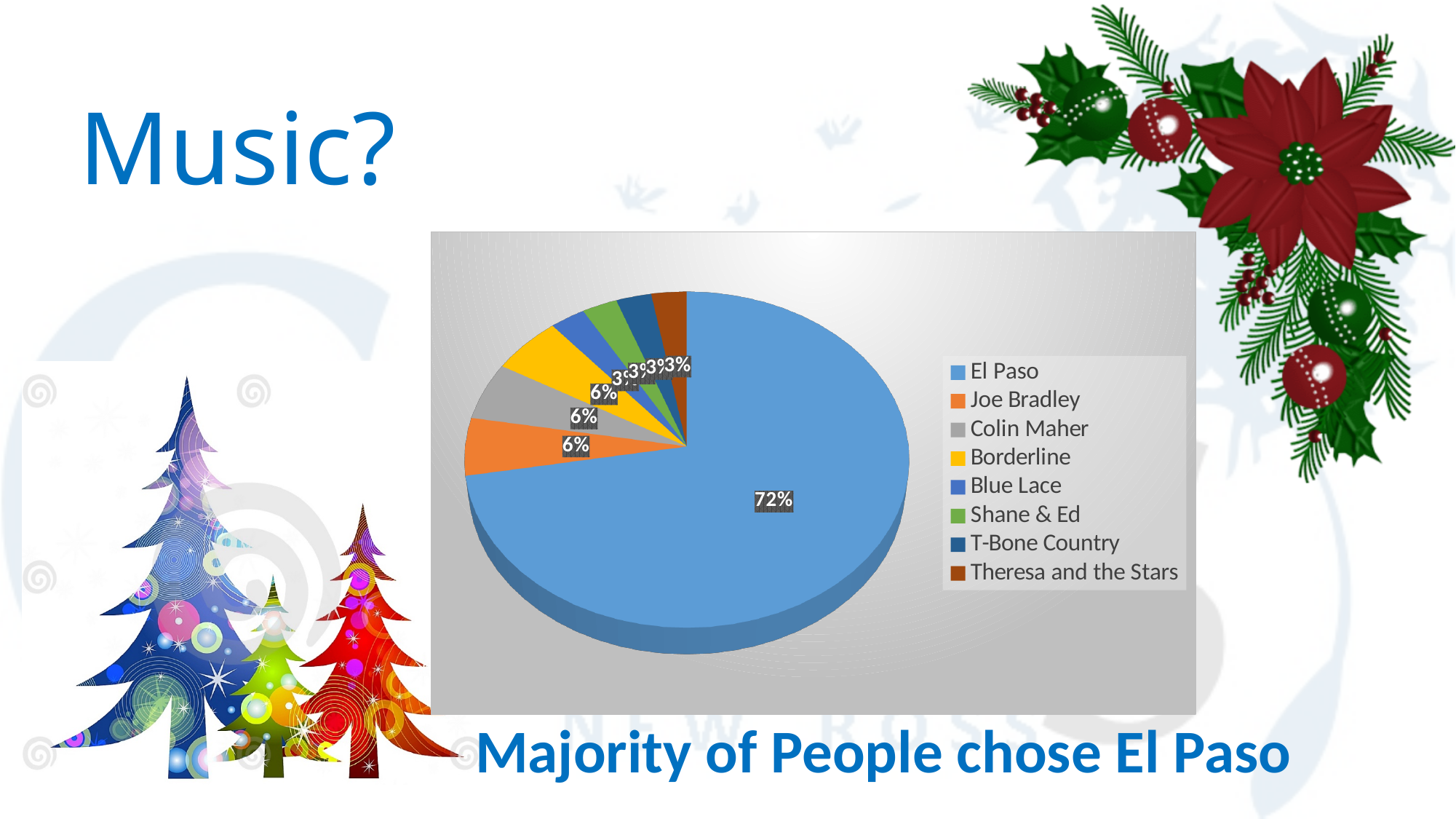
What percentage is shown for Borderline? 6% What share of the pie does El Paso have? 72% How many categories does the pie chart have? 8 What colour is the El Paso slice in the pie chart? Blue What percentage is shown for Joe Bradley? 6% Which is larger, the slice for El Paso or the slice for Borderline? El Paso What percentage is shown for Theresa and the Stars? 3% Is the share for El Paso greater or less than 50%? greater What kind of chart is shown on the slide? Pie chart What is the caption written below the chart? Majority of People chose El Paso Which category has the largest slice of the pie? El Paso What is the difference in percentage points between El Paso and Colin Maher? 66%